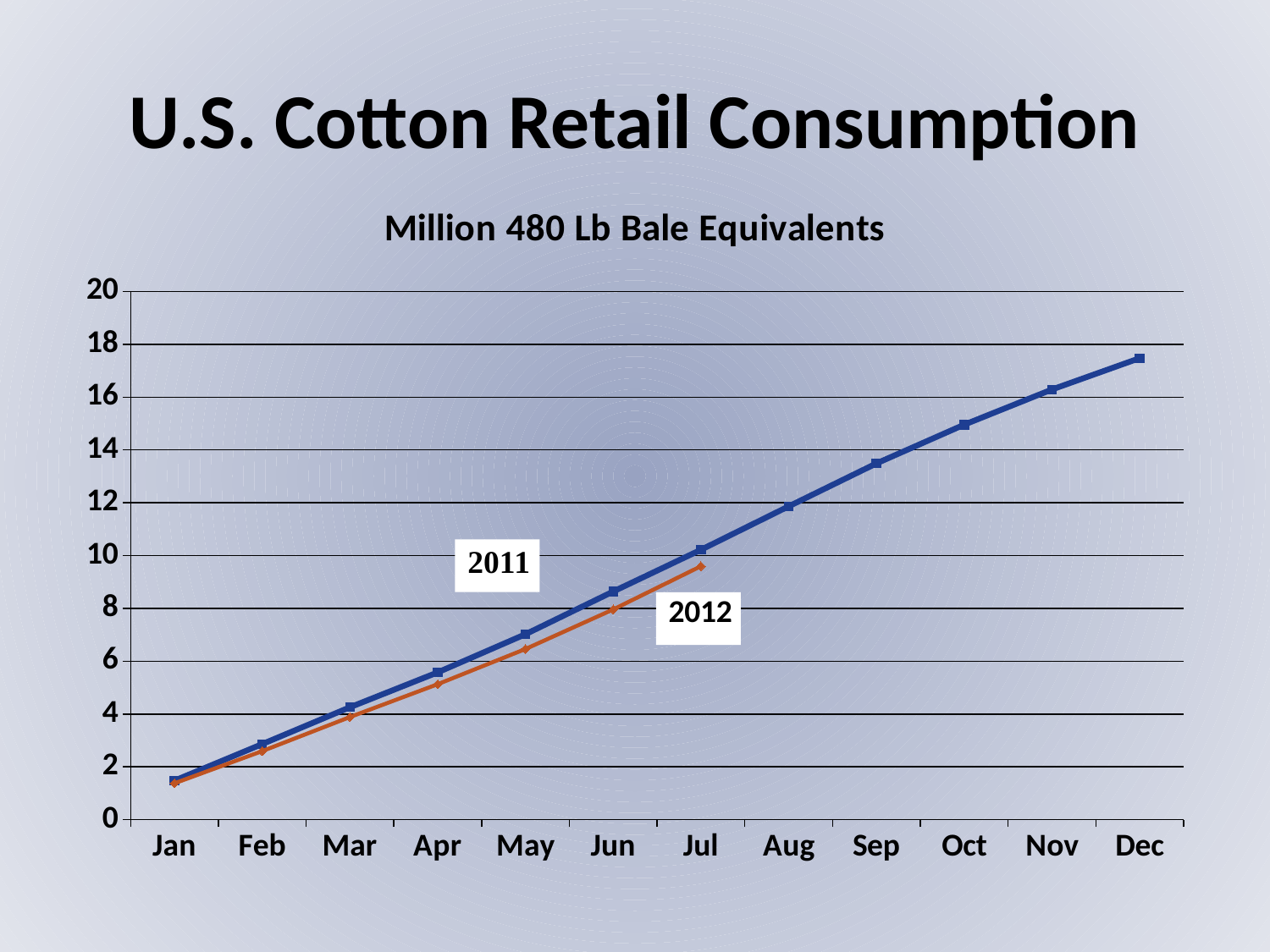
How many data series are plotted on the chart? 2 In which month is the 2011 series at its lowest value? Jan Is the value for 2012 in Jul greater or less than 10? less Is the value for 2011 in Sep greater or less than 12? greater What unit is given in the chart's subtitle? Million 480 Lb Bale Equivalents In Jun, which series has the larger value, 2011 or 2012? 2011 Is the value for 2011 in Dec greater or less than 16? greater What kind of chart is shown on the slide? line chart In which month does the 2011 series reach its highest value? Dec Do the values for the 2011 series rise or fall from Jan to Dec? rise Which two years are labelled on the chart's lines? 2011 and 2012 How many months are shown along the x axis? 12